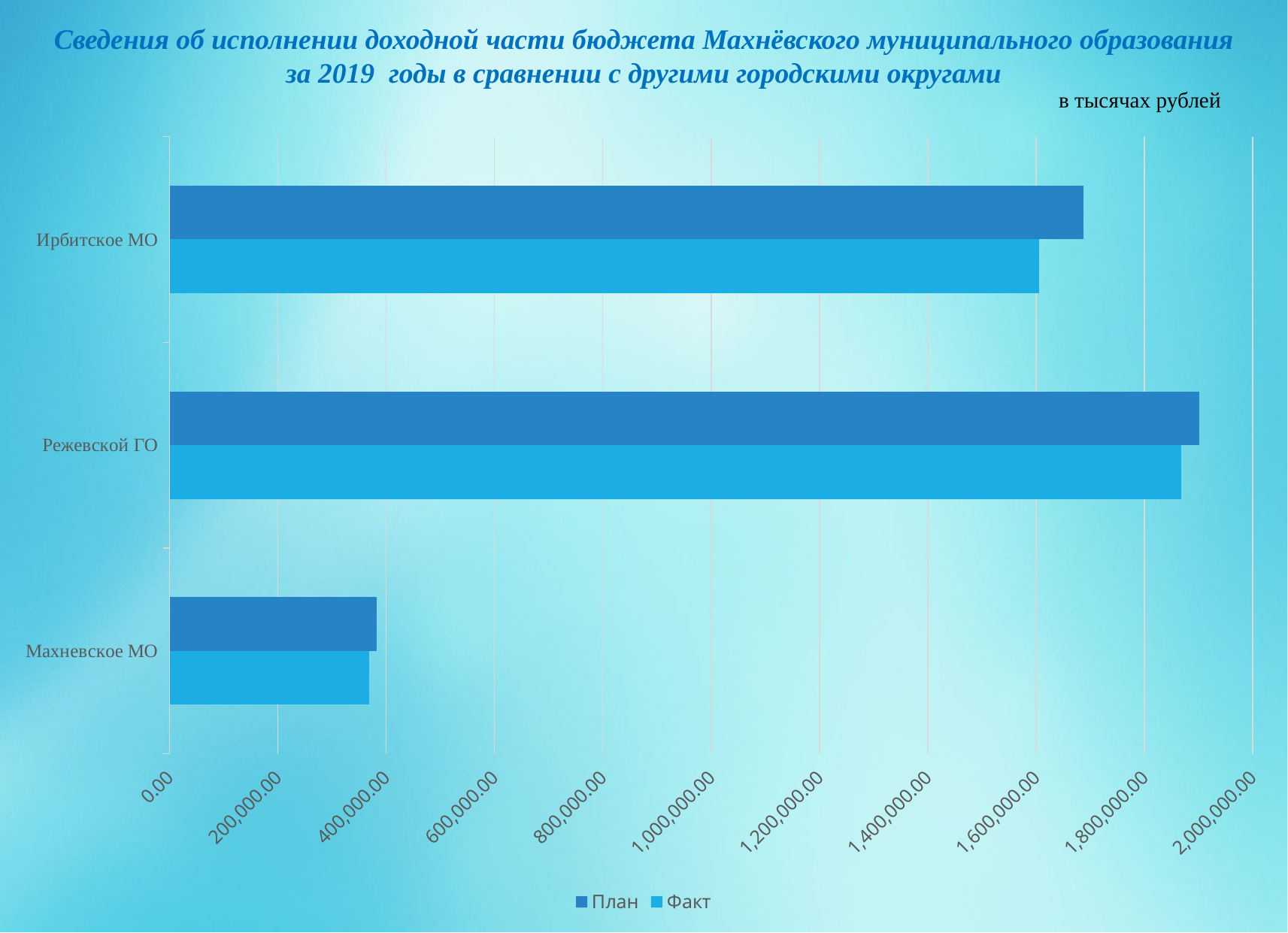
What are the two series named in the legend? План and Факт Is the Факт value for Режевской ГО greater or less than 1,800,000.00? greater Is the План value for Ирбитское МО greater or less than 1,600,000.00? greater How many municipalities (categories) are shown on the chart? 3 Is the Факт value for Ирбитское МО greater or less than 1,800,000.00? less How many series does the legend list? 2 Which is larger: the Факт value for Режевской ГО or the Факт value for Ирбитское МО? Режевской ГО Which category has the highest План value? Режевской ГО What kind of chart is shown on the slide? bar chart Which category has the lowest Факт value? Махневское МО For Ирбитское МО, which is larger: the План value or the Факт value? План